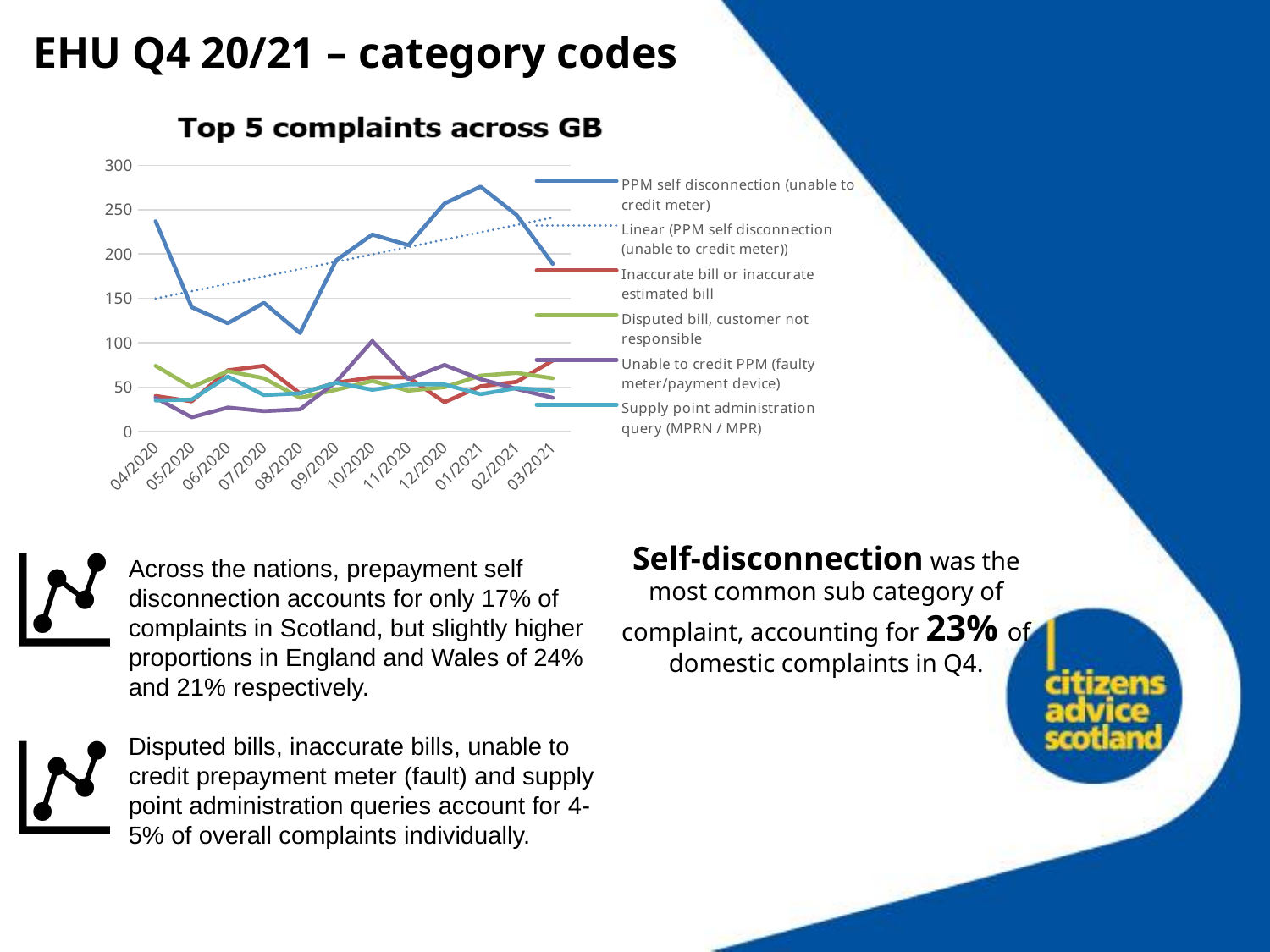
Is the value for Unable to credit PPM (faulty meter/payment device) in 10/2020 greater or less than 50? greater In which month does the PPM self disconnection (unable to credit meter) series reach its highest value? 01/2021 What is the title of the chart? Top 5 complaints across GB How many months are plotted along the x axis of the chart? 12 What kind of chart is shown on the slide? Line chart Is the value for PPM self disconnection (unable to credit meter) in 08/2020 greater or less than 150? less Which series has the highest values across the chart? PPM self disconnection (unable to credit meter) How many entries does the chart's legend list? 6 Is the value for PPM self disconnection (unable to credit meter) in 01/2021 greater or less than 250? greater Which legend entry is drawn as a dotted line? Linear (PPM self disconnection (unable to credit meter)) For PPM self disconnection (unable to credit meter), is the value higher in 04/2020 or in 01/2021? 01/2021